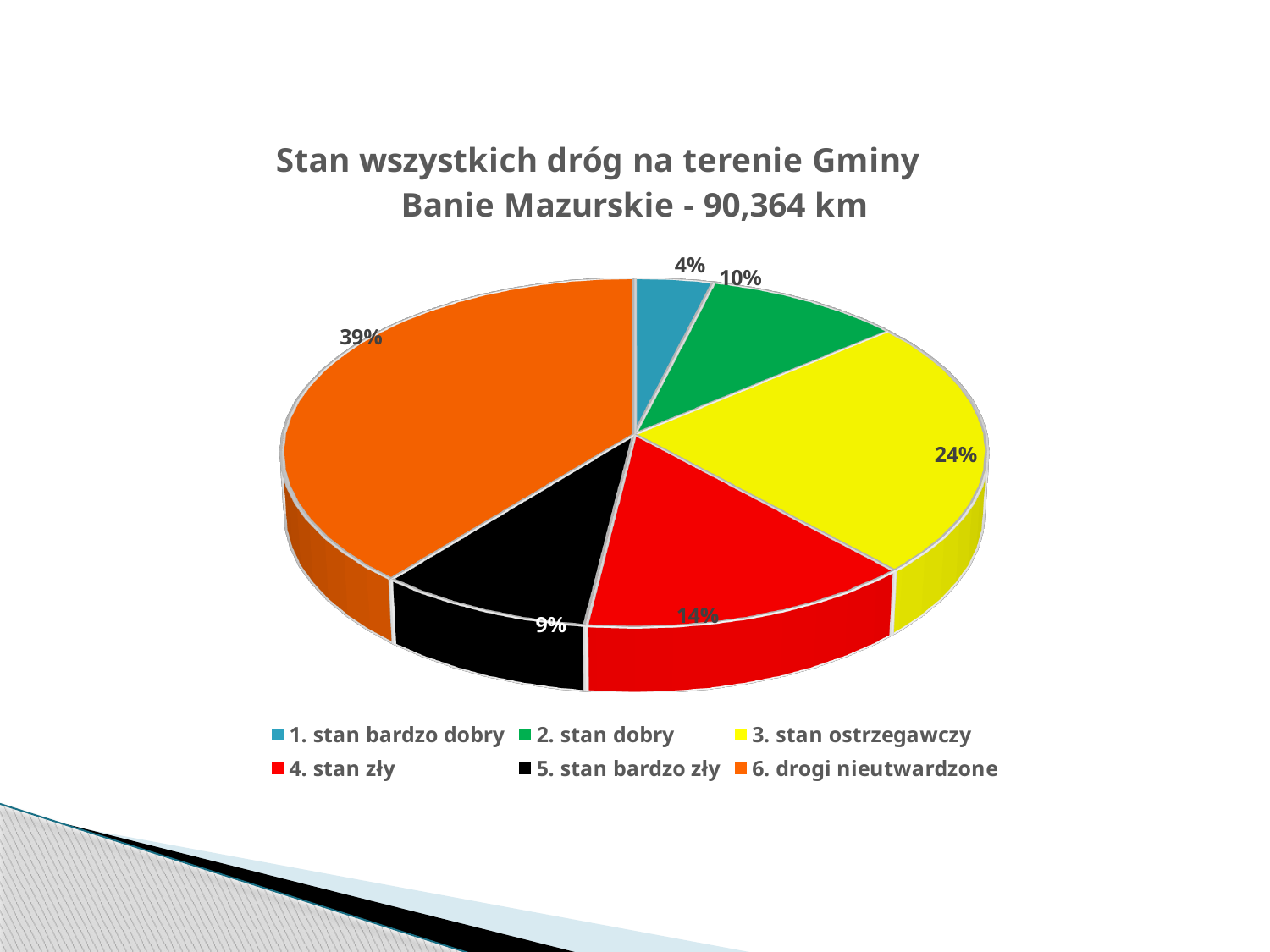
What share of the pie does '4. stan zły' represent? 14% What share of the pie does '5. stan bardzo zły' represent? 9% What is the title of the chart? Stan wszystkich dróg na terenie Gminy Banie Mazurskie - 90,364 km Which is larger, the slice for '4. stan zły' or the slice for '5. stan bardzo zły'? 4. stan zły What share of the pie does '3. stan ostrzegawczy' represent? 24% Which category has the largest slice of the pie? 6. drogi nieutwardzone Which category has the smallest slice of the pie? 1. stan bardzo dobry What is the difference in percentage points between '3. stan ostrzegawczy' and '2. stan dobry'? 14 How many categories does the pie chart have? 6 What type of chart is shown on the slide? pie chart